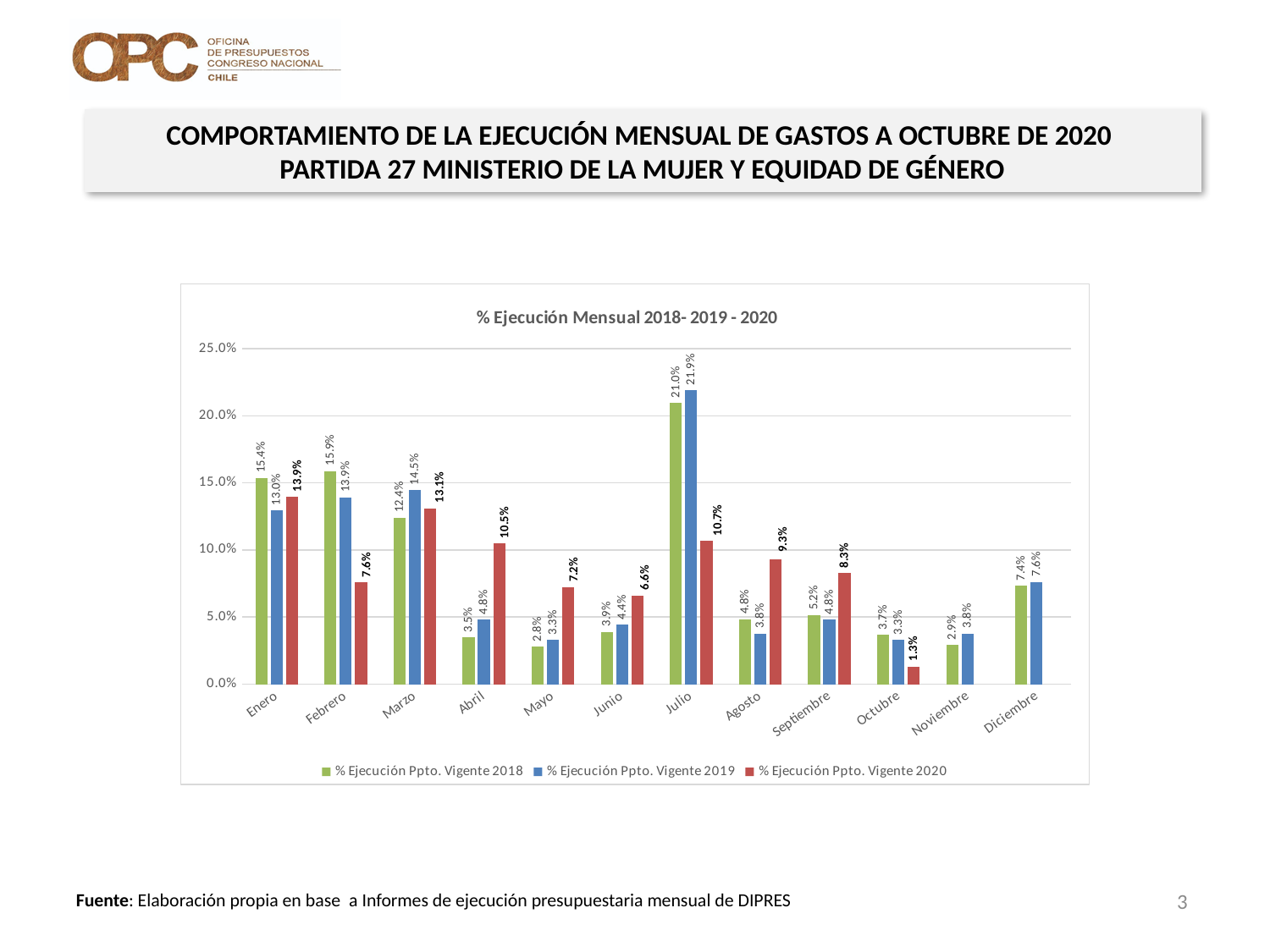
How many series does the legend list? 3 What kind of chart is shown on the slide? Bar chart What is the value for % Ejecución Ppto. Vigente 2018 in Julio? 21.0% What is the title of the chart? % Ejecución Mensual 2018- 2019 - 2020 Which is larger in Febrero: the 2018 value or the 2020 value? 2018 value (15.9%) What is the value for % Ejecución Ppto. Vigente 2020 in Abril? 10.5% What is the difference between the 2019 and 2018 values in Julio? 0.9% What is the value for % Ejecución Ppto. Vigente 2019 in Marzo? 14.5% In which month is the % Ejecución Ppto. Vigente 2020 series lowest? Octubre How many months are shown on the x axis? 12 Does the % Ejecución Ppto. Vigente 2020 series rise or fall from Julio to Octubre? Fall In which month is the % Ejecución Ppto. Vigente 2019 series highest? Julio